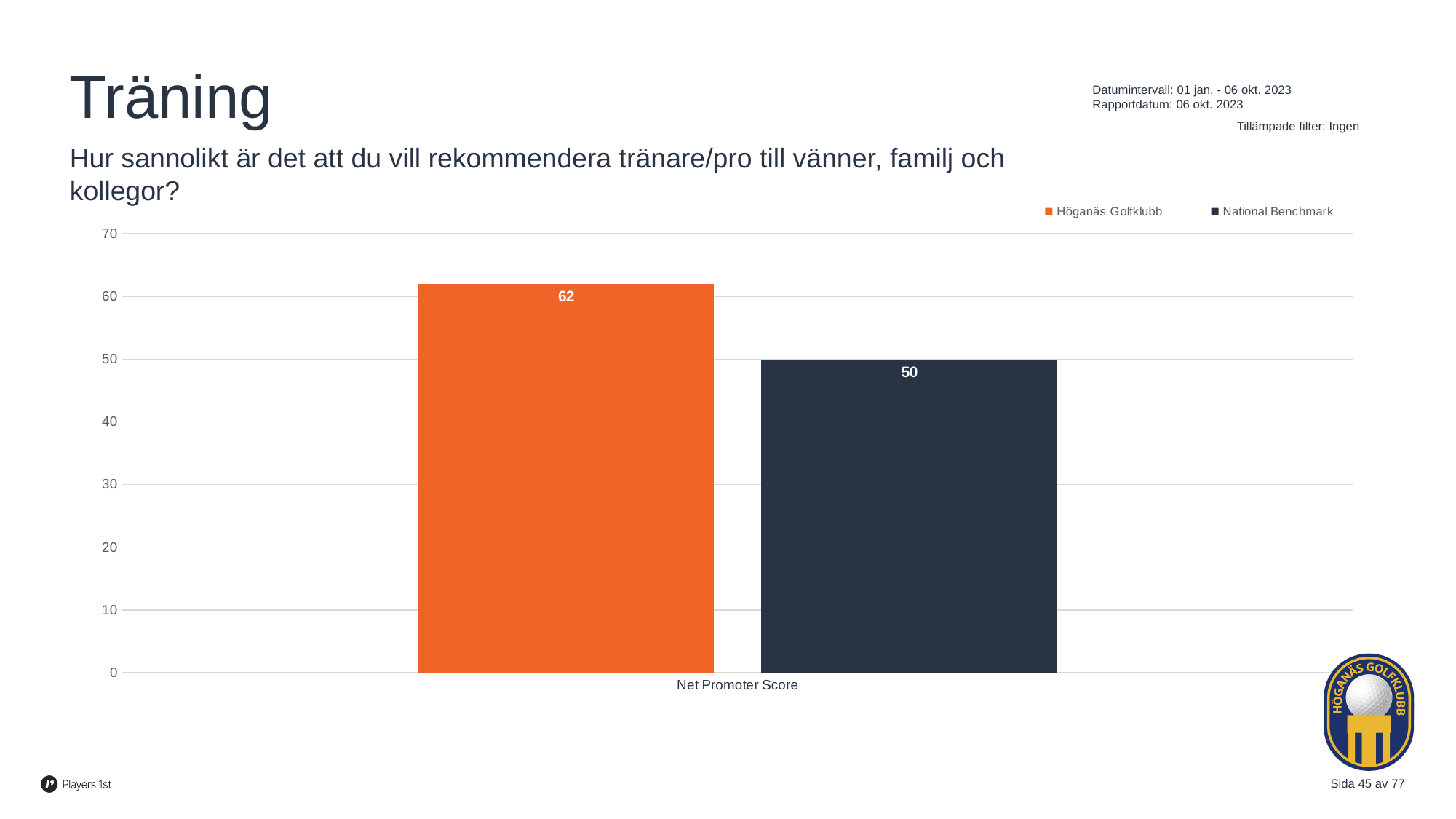
What is the Net Promoter Score for Höganäs Golfklubb? 62 Is the Net Promoter Score for Höganäs Golfklubb greater or less than 60? greater What colour is the bar for Höganäs Golfklubb? orange Is the Net Promoter Score for Höganäs Golfklubb larger or smaller than that for National Benchmark? larger Which series has the higher Net Promoter Score? Höganäs Golfklubb What kind of chart is shown on the slide? bar chart Is the Net Promoter Score for National Benchmark greater or less than 60? less What is the difference between the Höganäs Golfklubb and National Benchmark Net Promoter Scores? 12 Which series has the lower Net Promoter Score? National Benchmark What is the Net Promoter Score for National Benchmark? 50 How many categories are shown on the x axis? 1 How many series does the legend list? 2